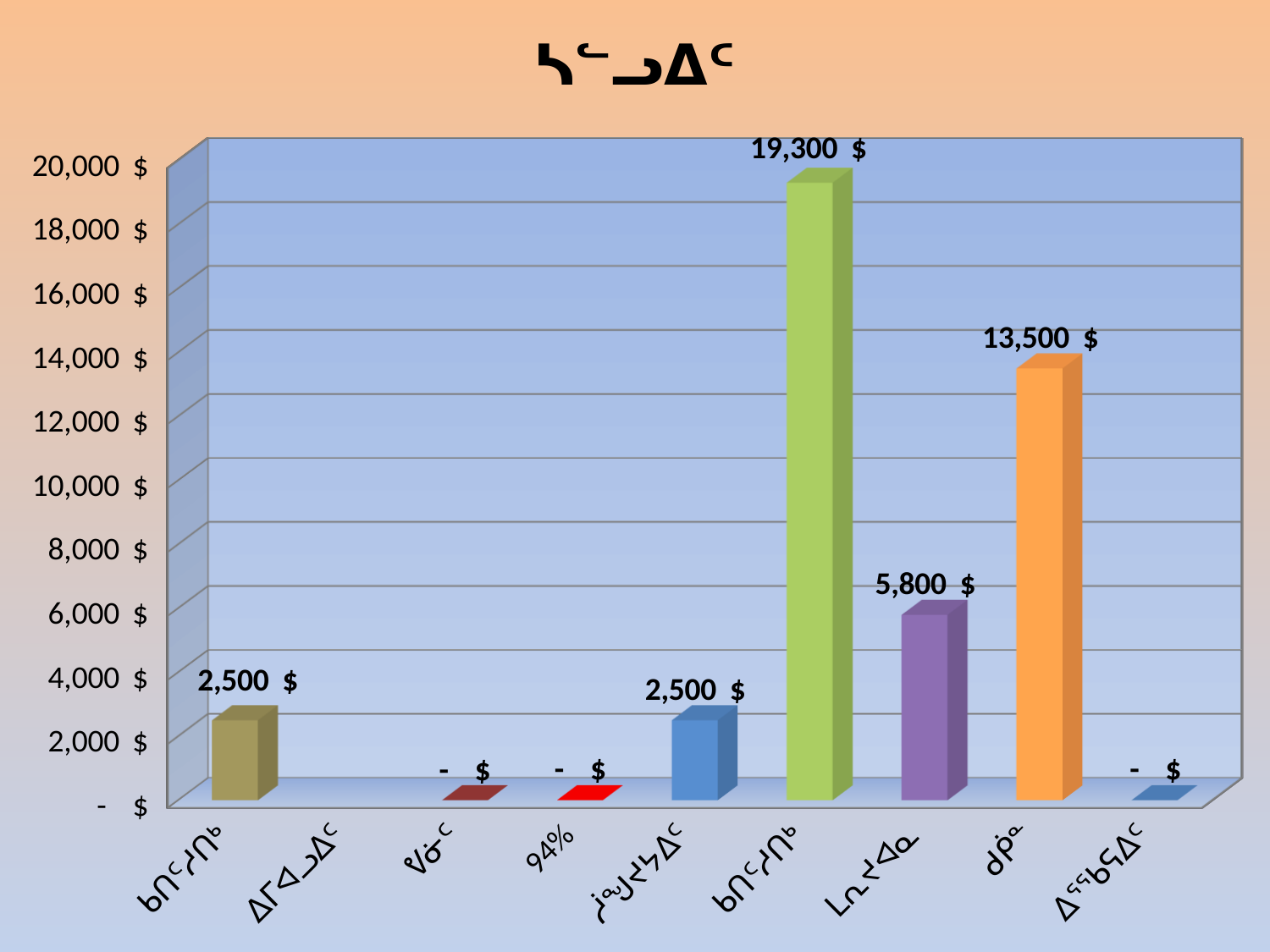
Which is larger, the purple bar or the orange bar? the orange bar How many categories are shown along the x axis? 9 What is the value of the orange bar (eighth from the left)? 13,500 $ What is the value shown for the category labelled "94%"? - $ What kind of chart is shown on the slide? bar chart What is the value of the purple bar (seventh from the left)? 5,800 $ What is the value of the green bar (sixth from the left)? 19,300 $ What is the highest tick value shown on the y axis? 20,000 $ What is the value of the first bar from the left? 2,500 $ Is the value of the orange bar greater or less than 10,000 $? greater What is the highest value shown in the chart? 19,300 $ What is the difference between the green bar (19,300 $) and the orange bar (13,500 $)? 5,800 $